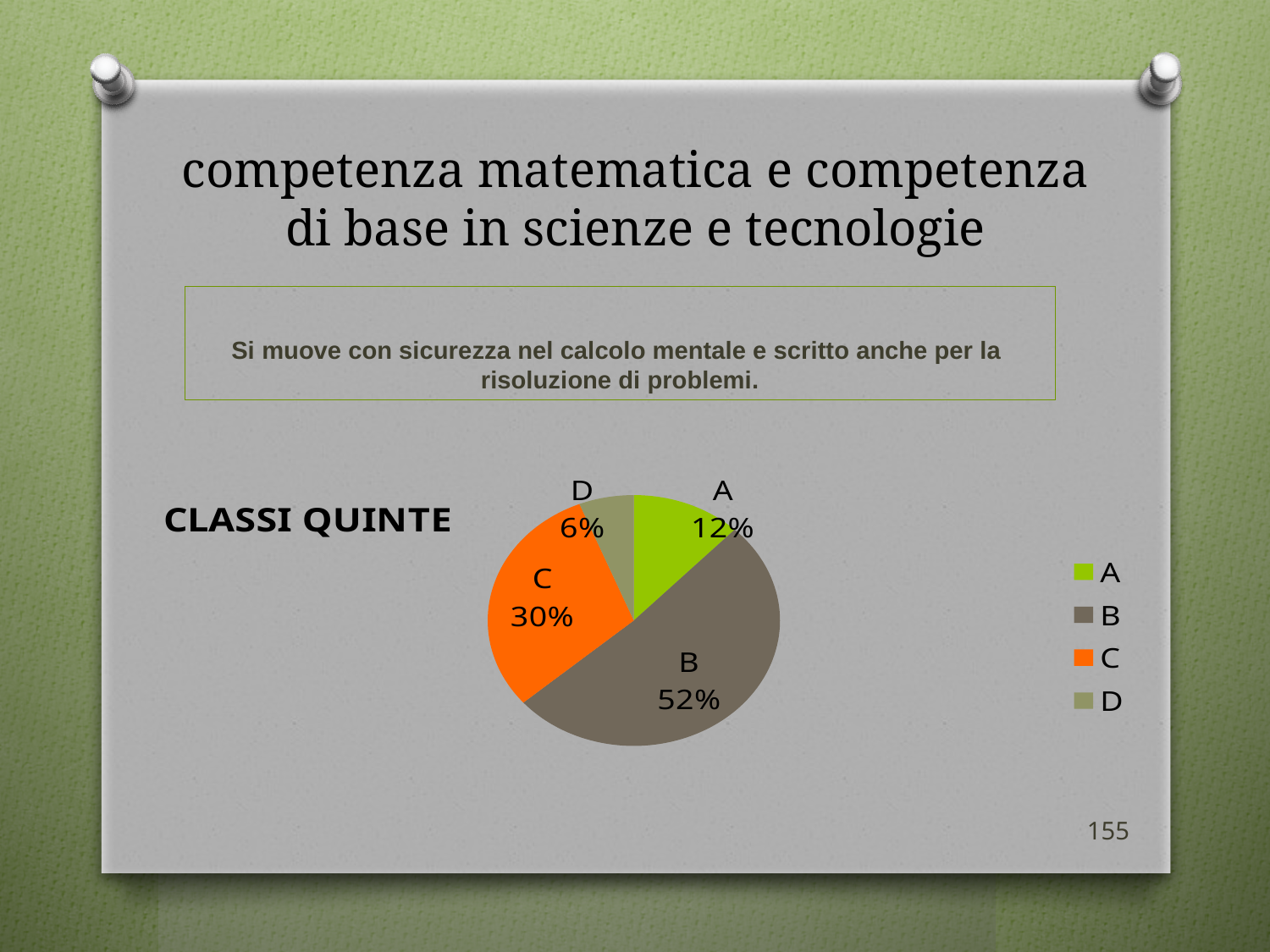
Which slice is the smallest in the pie chart? D What kind of chart is shown on the slide? pie chart How many slices does the pie chart have? 4 What percentage does slice A represent in the pie chart? 12% What percentage does slice D represent in the pie chart? 6% Which slice is the largest in the pie chart? B What percentage does slice B represent in the pie chart? 52% What percentage does slice C represent in the pie chart? 30% Which is larger, slice A or slice C? C What is the difference in percentage points between slice B and slice C? 22 How many entries does the legend list? 4 What colour is slice C in the pie chart? orange